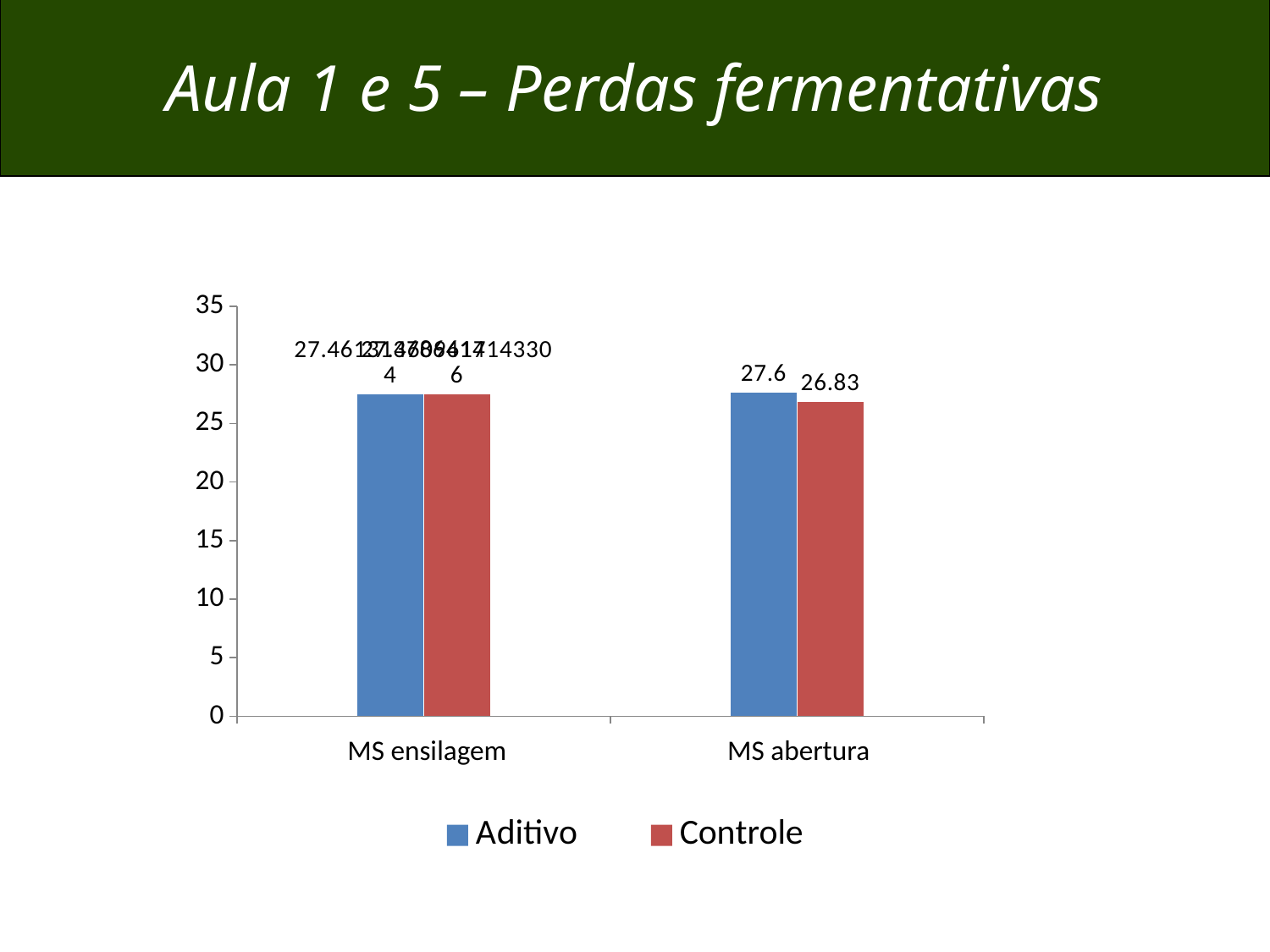
Is the value for Controle in the MS ensilagem category greater or less than 30? less How many series does the legend list? 2 In the MS abertura category, which series has the larger value, Aditivo or Controle? Aditivo Is the value for Aditivo in the MS ensilagem category greater or less than 25? greater What is the title of the slide? Aula 1 e 5 – Perdas fermentativas What is the value for Controle in the MS abertura category? 26.83 How many categories are shown on the x axis of the chart? 2 What are the two series named in the legend? Aditivo and Controle What is the difference between the Aditivo and Controle values in the MS abertura category? 0.77 What kind of chart is shown on the slide? Bar chart Is the value for Controle in the MS abertura category greater or less than 30? less What is the value for Aditivo in the MS abertura category? 27.6